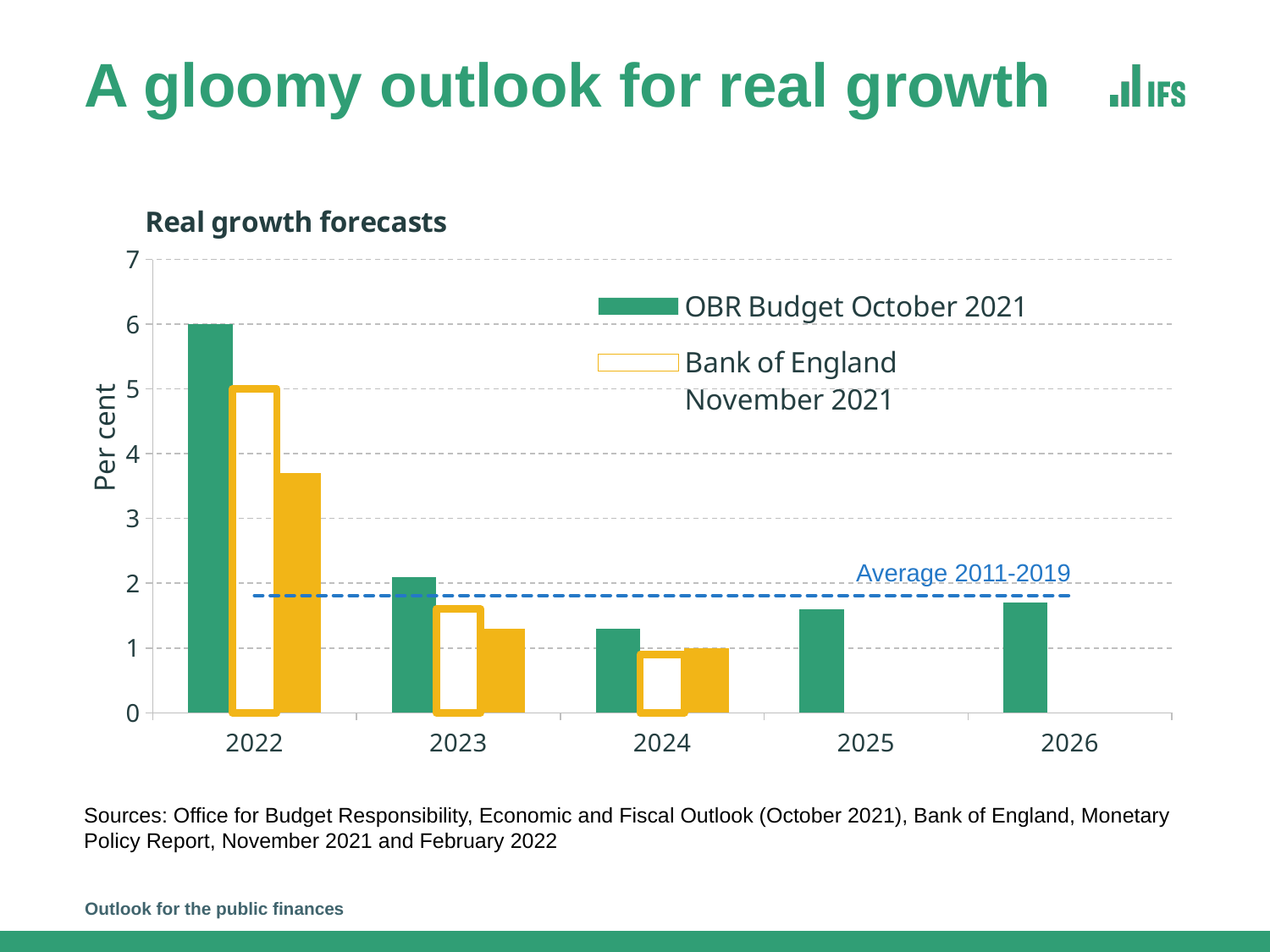
How many years are shown on the x axis of the chart? 5 In which year is the OBR Budget October 2021 forecast highest? 2022 Is the Bank of England November 2021 forecast for 2022 greater or less than 4? greater For 2022, which is larger: the OBR Budget October 2021 forecast or the Bank of England November 2021 forecast? OBR Budget October 2021 For 2023, which is larger: the OBR Budget October 2021 forecast or the Bank of England November 2021 forecast? OBR Budget October 2021 How many series does the chart's legend list? 2 Is the OBR Budget October 2021 forecast for 2022 greater or less than 5? greater In which year is the OBR Budget October 2021 forecast lowest? 2024 Is the OBR Budget October 2021 forecast for 2024 greater or less than 2? less What type of chart is shown on the slide? Bar chart What does the dashed horizontal line on the chart represent? Average 2011-2019 Does the OBR Budget October 2021 forecast rise or fall from 2022 to 2024? Fall